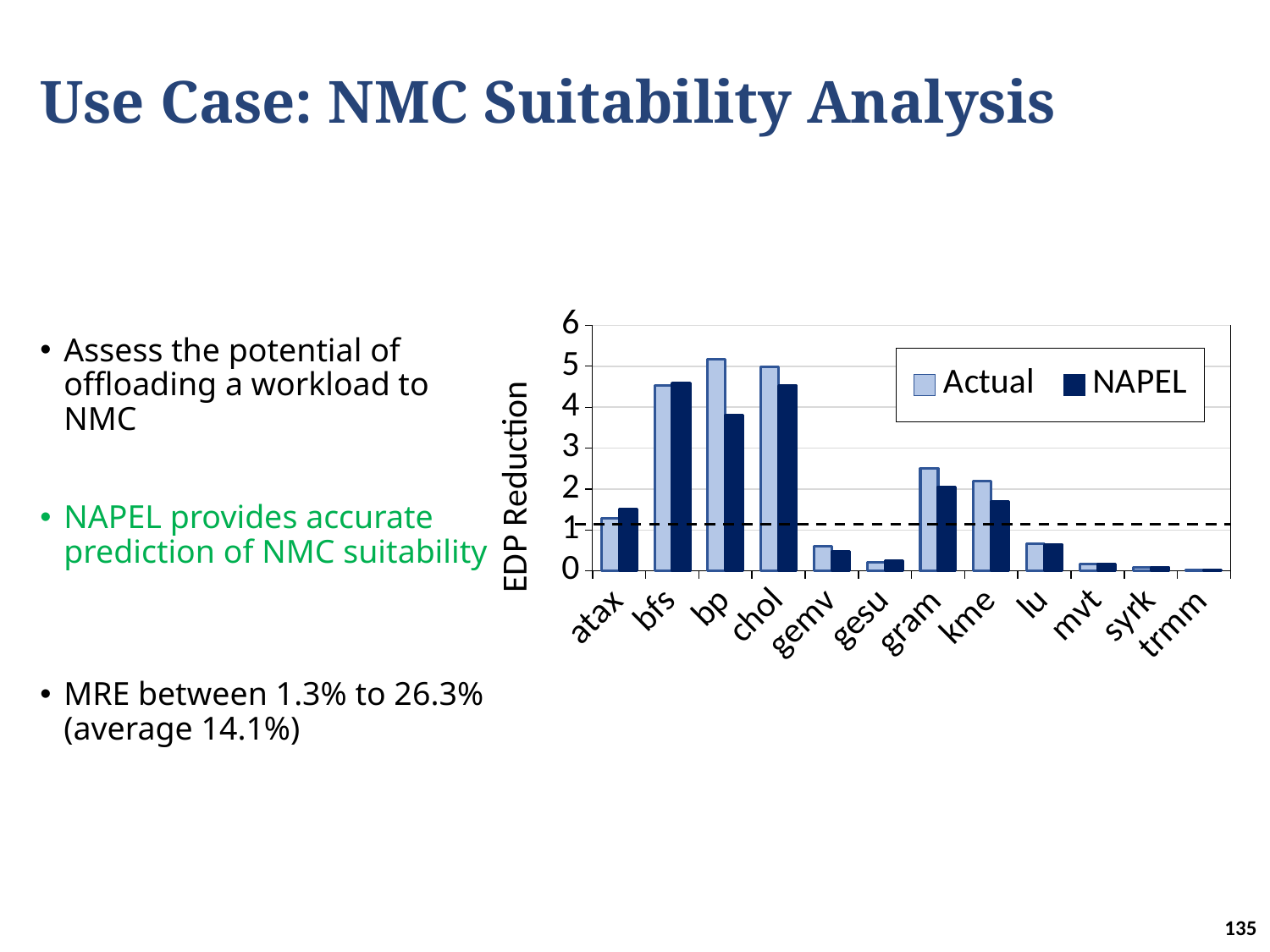
What is the label of the chart's y axis? EDP Reduction For bp, which is larger: the Actual value or the NAPEL value? Actual Is the Actual value for gemv greater or less than 1? less Is the Actual value for bfs greater or less than 4? greater How many workload categories are shown on the x axis of the chart? 12 What are the two series named in the chart's legend? Actual and NAPEL For atax, which is larger: the Actual value or the NAPEL value? NAPEL Is the NAPEL value for kme greater or less than 2? less How many series does the chart's legend list? 2 What kind of chart is shown on the slide? bar chart For kme, which is larger: the Actual value or the NAPEL value? Actual Which workload has the lowest Actual EDP Reduction? trmm